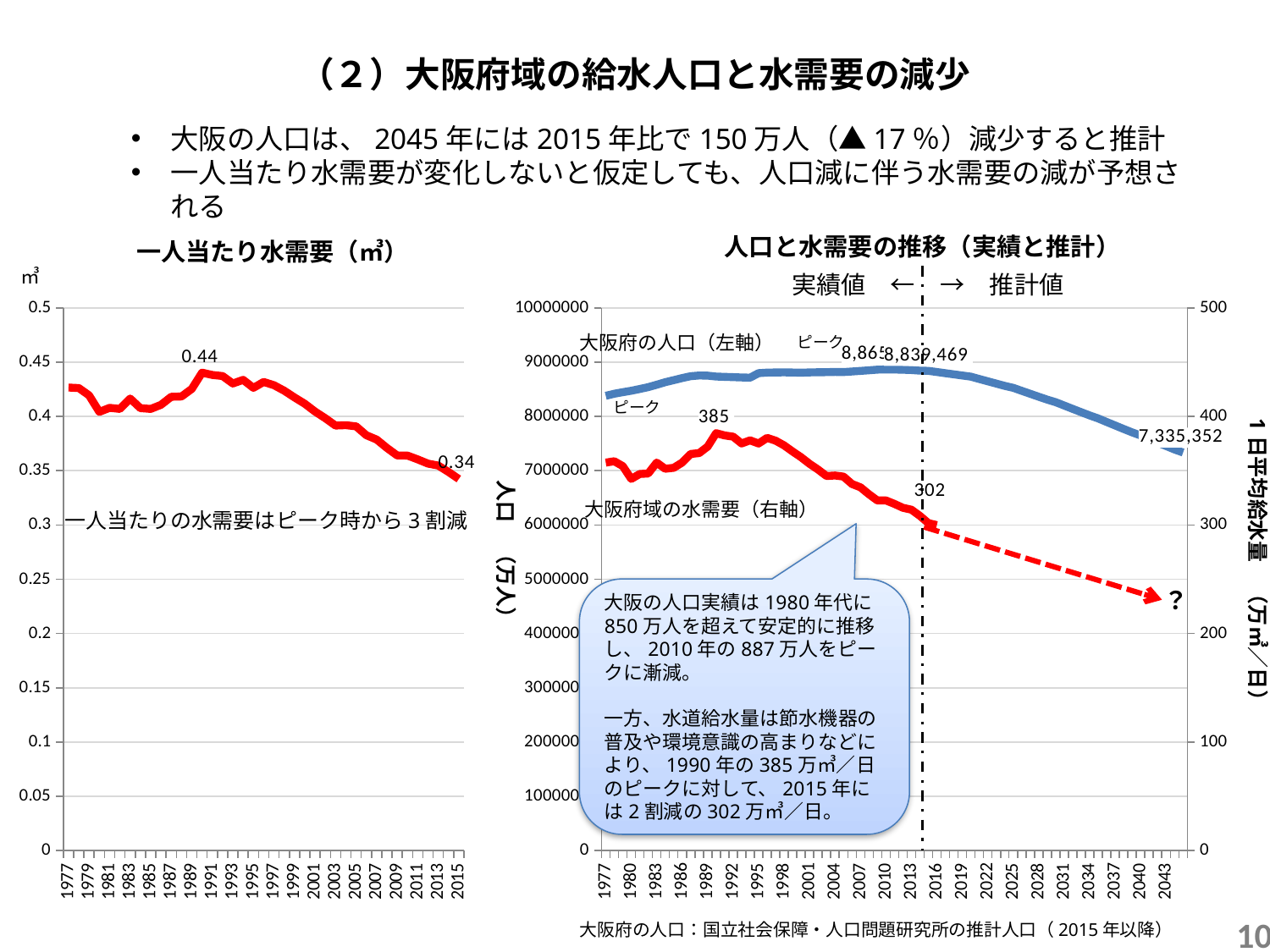
On the left chart (一人当たり水需要), what is the difference between the labelled peak value and the labelled 2015 value? 0.10 On the right chart (人口と水需要の推移), is the population value at the end of the projection greater or less than 8000000? less On the left chart (一人当たり水需要), does the value generally rise or fall from 1991 to 2015? fall On the left chart (一人当たり水需要), what is the value labelled at the end of the line in 2015? 0.34 What kind of chart is the left chart (一人当たり水需要)? line chart On the right chart (人口と水需要の推移), what is the labelled peak value of the water demand line (大阪府域の水需要)? 385 On the right chart (人口と水需要の推移), what is the labelled water demand value at the end of the actual (実績) period? 302 On the left chart (一人当たり水需要), what is the peak value labelled on the line? 0.44 On the left chart (一人当たり水需要), is the value for 2015 greater or less than 0.35? less On the right chart (人口と水需要の推移), what is the difference between the labelled peak water demand (385) and the labelled 2015 value (302)? 83 On the right chart (人口と水需要の推移), what is the labelled population value at the end of the projection line? 7,335,352 On the right chart (人口と水需要の推移), which axis is the population (大阪府の人口) plotted against, the left or the right? left axis